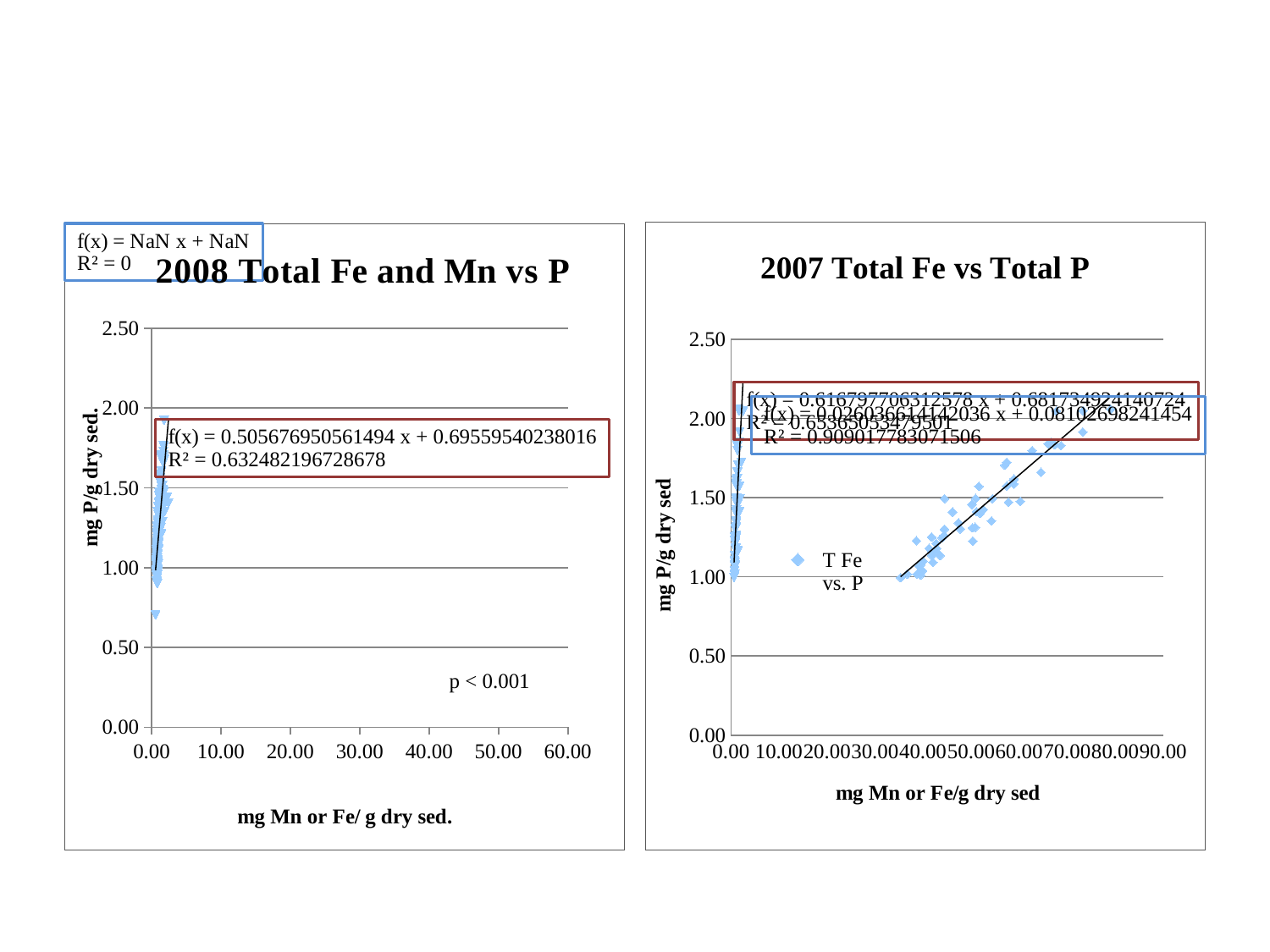
In the left chart "2008 Total Fe and Mn vs P", what is the highest value shown on the x axis? 60.00 What kind of chart is the left chart titled "2008 Total Fe and Mn vs P"? scatter chart In the right chart "2007 Total Fe vs Total P", what is the R² value shown in the blue-bordered trendline label? 0.909017783071506 In the right chart "2007 Total Fe vs Total P", do the plotted P values rise or fall as the x-axis value increases? rise What kind of chart is the right chart titled "2007 Total Fe vs Total P"? scatter chart What legend entry is shown in the right chart "2007 Total Fe vs Total P"? T Fe vs. P In the right chart "2007 Total Fe vs Total P", what is the slope of the trendline in the red-bordered label? 0.616797706312578 In the left chart "2008 Total Fe and Mn vs P", what is the R² value shown in the red-bordered trendline label? 0.632482196728678 What is the x-axis label of the right chart "2007 Total Fe vs Total P"? mg Mn or Fe/g dry sed In the right chart "2007 Total Fe vs Total P", what is the highest value shown on the y axis? 2.50 In the left chart "2008 Total Fe and Mn vs P", what p-value is printed on the chart? p < 0.001